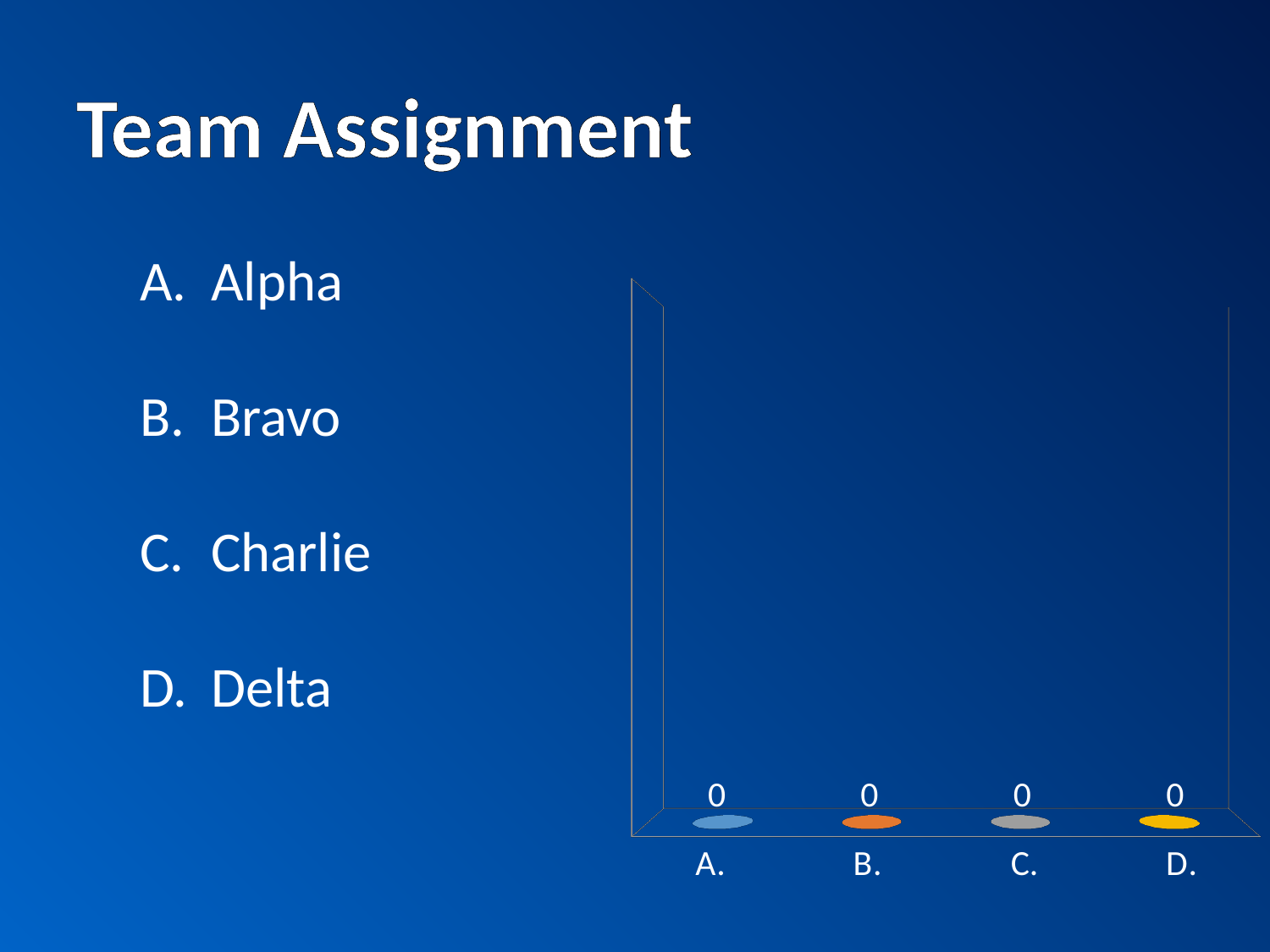
What are the category labels along the x axis of the chart? A., B., C., D. What is the value shown for category A. in the chart? 0 What is the difference between the values for A. and D. in the chart? 0 What is the value shown for category C. in the chart? 0 What is the value shown for category B. in the chart? 0 What is the value shown for category D. in the chart? 0 How many categories are shown on the x axis of the chart? 4 What type of chart is shown on the slide? bar chart What colour is the bar for category B. in the chart? orange